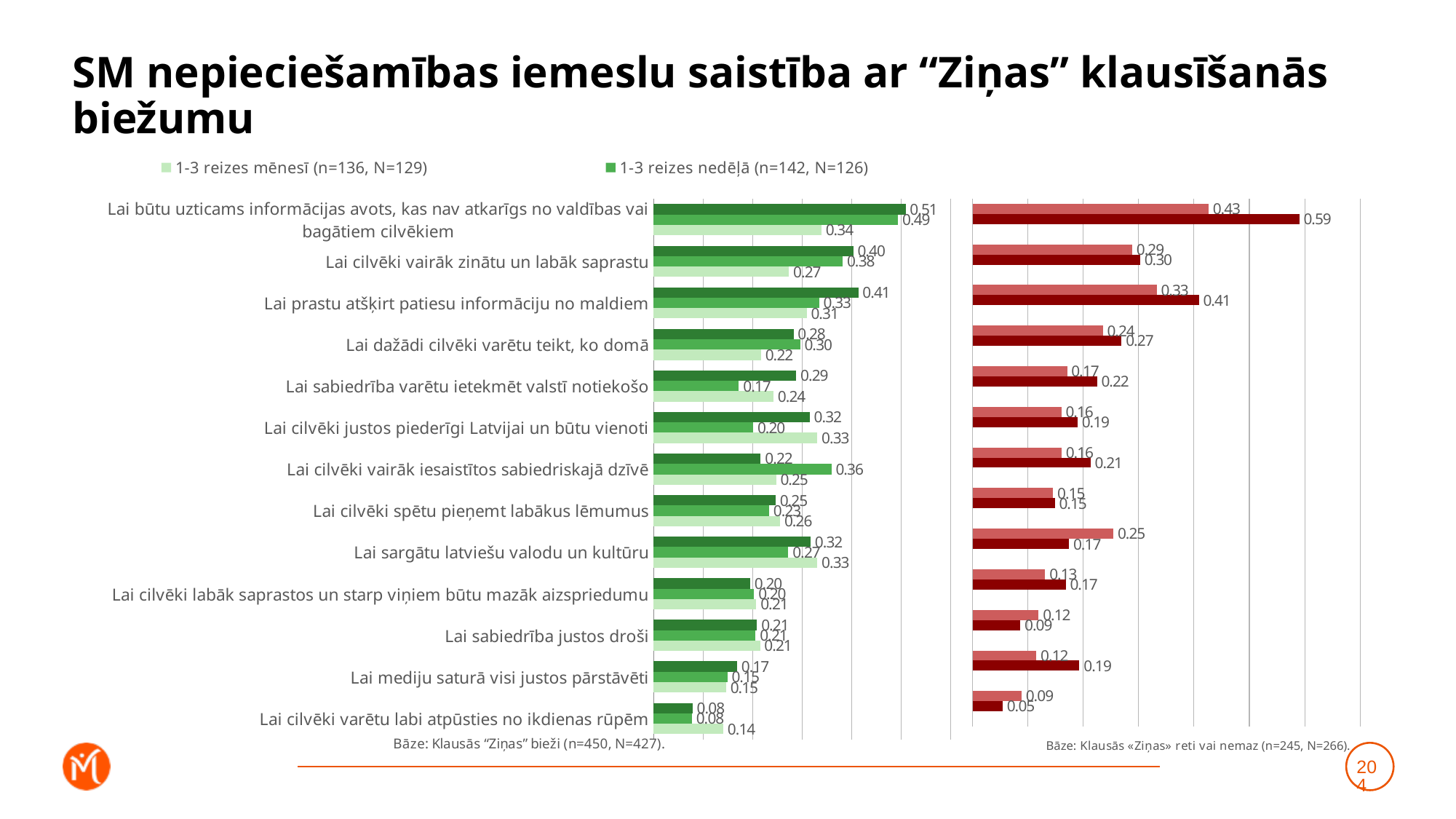
How many series does the legend at the top of the slide list? 2 How many categories (reasons) are listed on the left (green) chart? 13 On the right (red) chart, what is the value of the lighter red bar for "Lai prastu atšķirt patiesu informāciju no maldiem"? 0.33 On the left (green) chart, what is the difference between the "1-3 reizes mēnesī" values for "Lai būtu uzticams informācijas avots, kas nav atkarīgs no valdības vai bagātiem cilvēkiem" (0.34) and "Lai cilvēki varētu labi atpūsties no ikdienas rūpēm" (0.14)? 0.20 On the right (red) chart, which category has the lowest value for the darker red bar? Lai cilvēki varētu labi atpūsties no ikdienas rūpēm What kind of chart is shown on the left of the slide? Bar chart On the right (red) chart, which category has the highest value for the darker red bar? Lai būtu uzticams informācijas avots, kas nav atkarīgs no valdības vai bagātiem cilvēkiem On the left (green) chart, what is the value of the "1-3 reizes mēnesī" series for "Lai būtu uzticams informācijas avots, kas nav atkarīgs no valdības vai bagātiem cilvēkiem"? 0.34 On the right (red) chart, what is the difference between the darker red bar (0.59) and the lighter red bar (0.43) for "Lai būtu uzticams informācijas avots, kas nav atkarīgs no valdības vai bagātiem cilvēkiem"? 0.16 On the left (green) chart, what is the value of the "1-3 reizes mēnesī" series for "Lai cilvēki varētu labi atpūsties no ikdienas rūpēm"? 0.14 On the left (green) chart, for the "1-3 reizes mēnesī" series, which is larger: "Lai cilvēki justos piederīgi Latvijai un būtu vienoti" or "Lai sabiedrība justos droši"? Lai cilvēki justos piederīgi Latvijai un būtu vienoti On the right (red) chart, what is the value of the darker red bar for "Lai būtu uzticams informācijas avots, kas nav atkarīgs no valdības vai bagātiem cilvēkiem"? 0.59